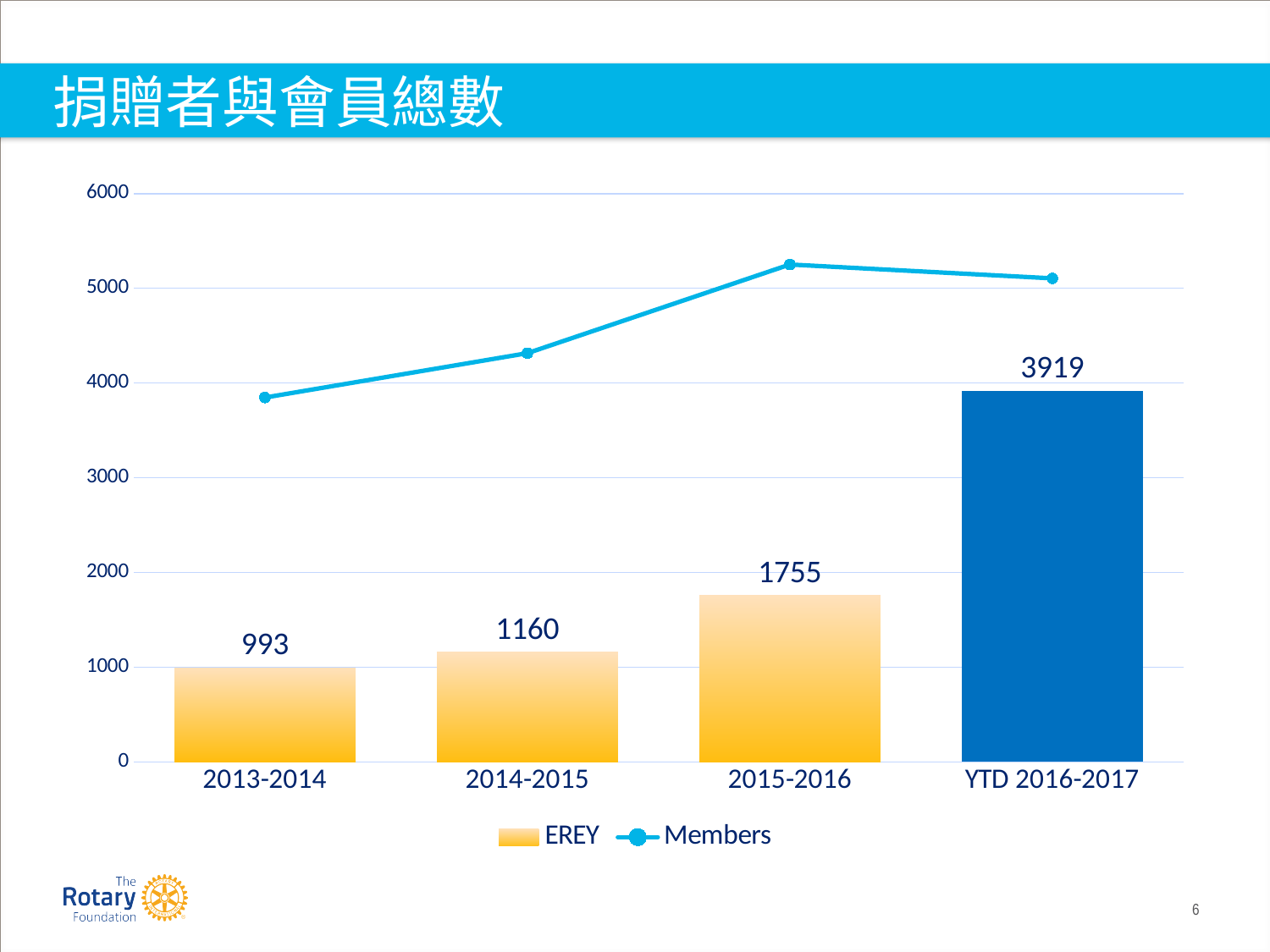
Is the Members value for 2013-2014 greater or less than 4000? less Which is larger, the EREY value for 2015-2016 or for 2014-2015? 2015-2016 How many categories are shown on the x axis? 4 Is the Members value for 2015-2016 greater or less than 5000? greater Which category has the lowest EREY value? 2013-2014 What is the EREY value for 2015-2016? 1755 How many series does the legend list? 2 What is the EREY value for YTD 2016-2017? 3919 What is the difference between the EREY values for 2014-2015 and 2013-2014? 167 Do the EREY values rise or fall from 2013-2014 to YTD 2016-2017? rise Which category has the highest EREY value? YTD 2016-2017 What is the EREY value for 2013-2014? 993